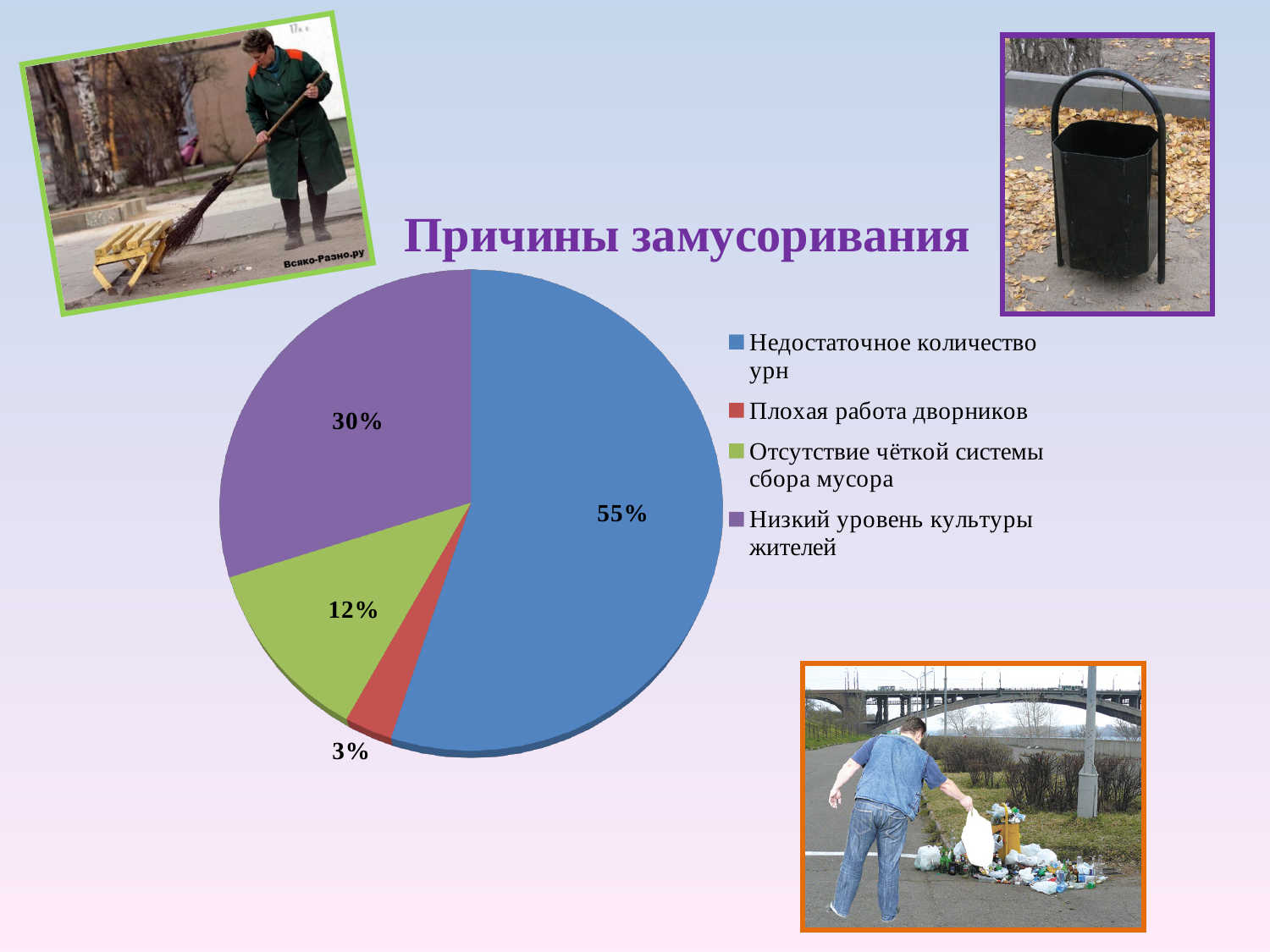
Which category has the largest slice of the pie? Недостаточное количество урн What share of the pie does "Недостаточное количество урн" account for? 55% Which category has the smallest slice of the pie? Плохая работа дворников What share of the pie does "Отсутствие чёткой системы сбора мусора" account for? 12% What share of the pie does "Низкий уровень культуры жителей" account for? 30% What kind of chart is shown on the slide? Pie chart What colour is the slice for "Низкий уровень культуры жителей"? Purple What is the title of the chart? Причины замусоривания Which is larger: the share for "Отсутствие чёткой системы сбора мусора" or for "Плохая работа дворников"? Отсутствие чёткой системы сбора мусора What is the difference in percentage points between "Недостаточное количество урн" and "Низкий уровень культуры жителей"? 25 How many categories are shown in the pie chart? 4